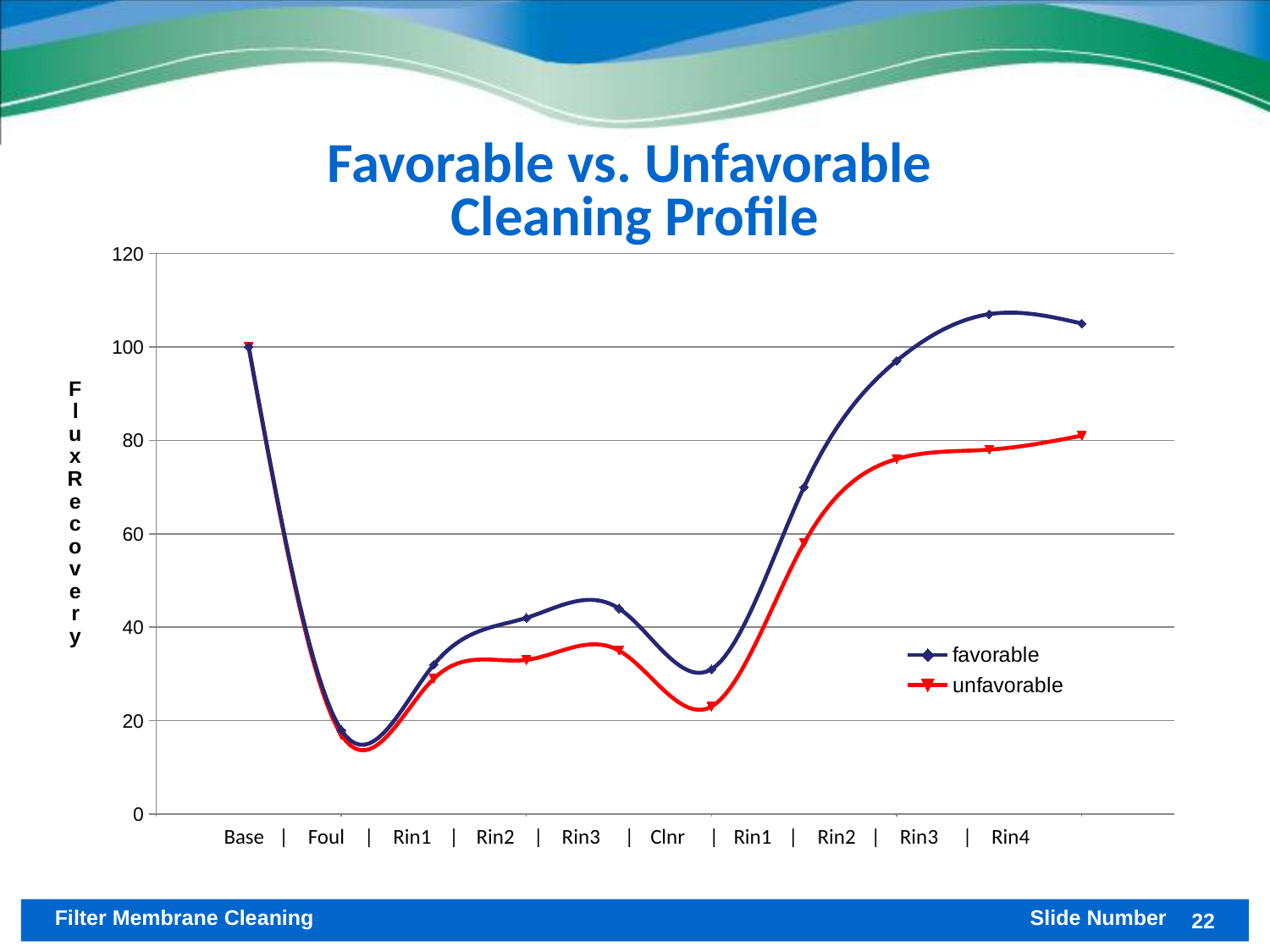
At the final Rin4 category, which series has the larger value, favorable or unfavorable? favorable Do the values of both series rise or fall from Clnr to the final Rin4? rise How many points are plotted along the x axis for each series? 10 At which x-axis category does the favorable series reach its lowest value? Foul At which x-axis category does the unfavorable series reach its lowest value? Foul Is the value of the unfavorable series at the final Rin4 greater or less than 100? less What is the title of the chart? Favorable vs. Unfavorable Cleaning Profile Is the value of the unfavorable series at Clnr greater or less than 40? less What kind of chart is shown on the slide? line chart How many series does the legend list? 2 What is the value of the favorable series at Base? 100 Is the value of the favorable series at the final Rin4 greater or less than 100? greater